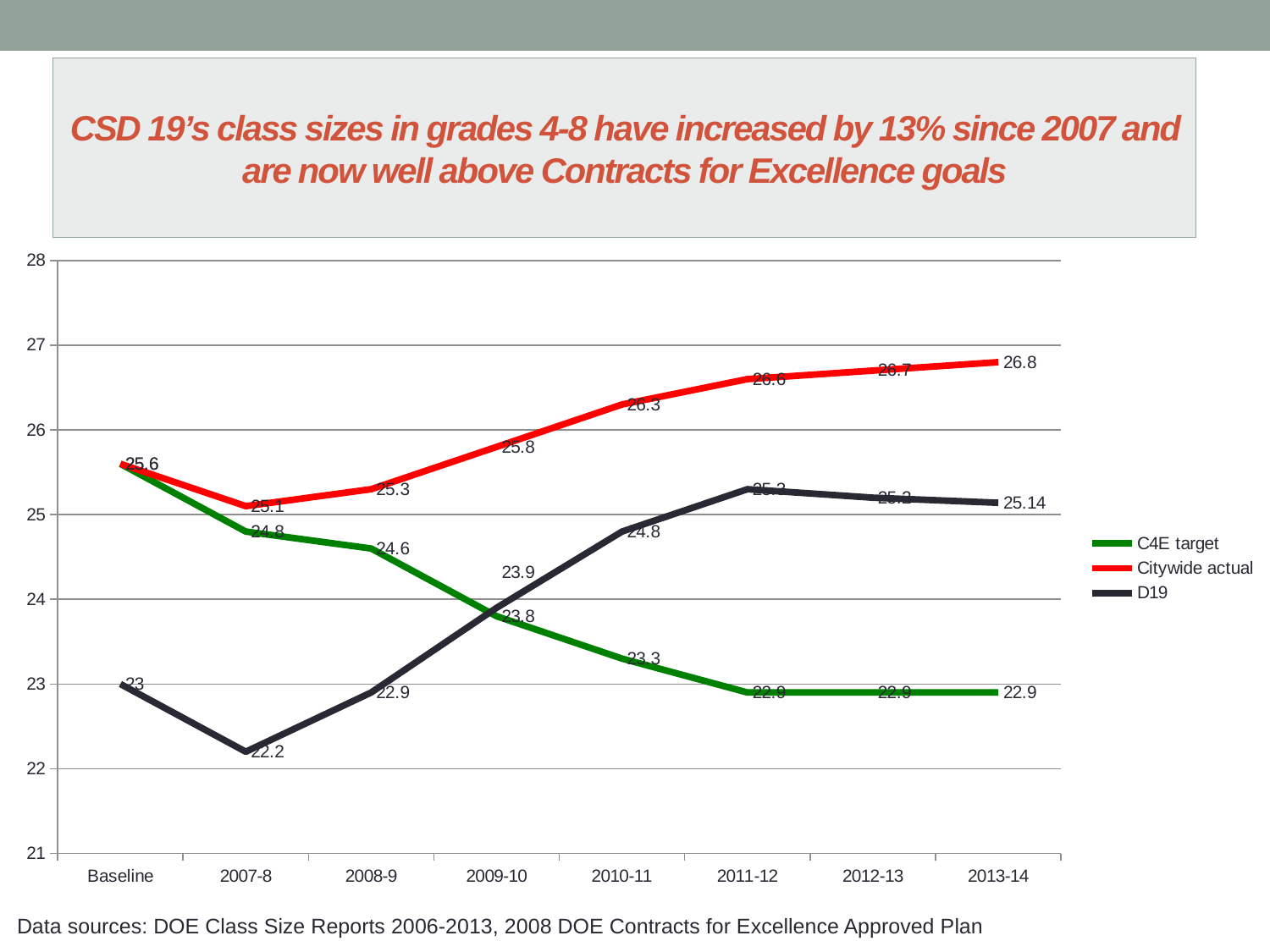
How many series does the legend list? 3 What is the difference between the D19 value and the C4E target value in 2013-14? 2.24 What is the Citywide actual value for 2013-14? 26.8 What is the D19 value for 2013-14? 25.14 In which year is the Citywide actual value highest? 2013-14 What is the Citywide actual value for 2009-10? 25.8 What is the C4E target value for 2010-11? 23.3 What is the D19 value at Baseline? 23 What kind of chart is shown on the slide? line chart Does the Citywide actual line rise or fall from 2007-8 to 2013-14? rises How many points are plotted along the x axis for each series? 8 In which year is the D19 value lowest? 2007-8